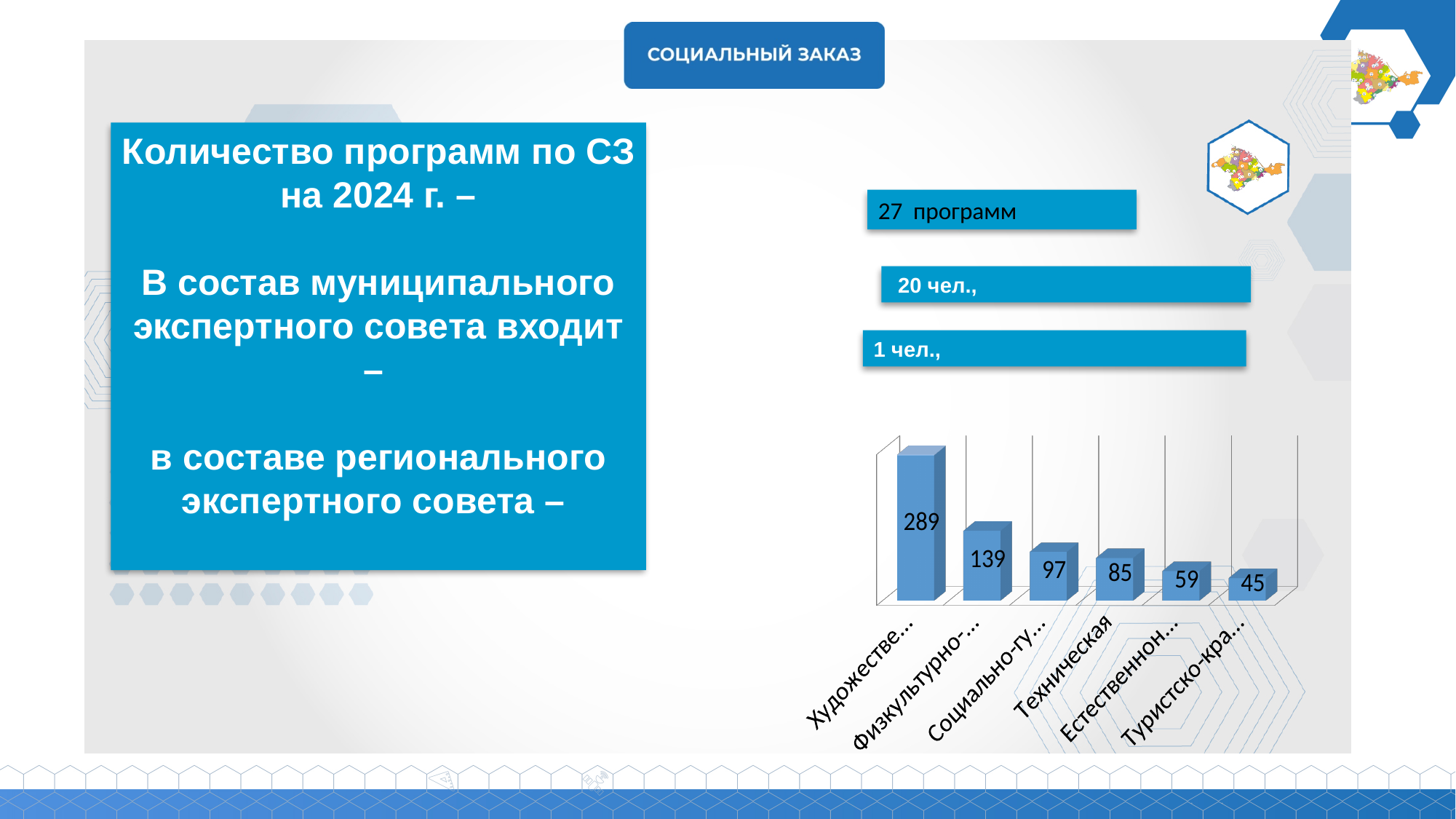
Which category has the highest value? Художестве... Which is larger, the value for "Социально-гу..." or the value for Техническая? Социально-гу... Do the values rise or fall from left to right along the x axis? Fall What kind of chart is shown on the slide? Bar chart What is the difference between the values for Техническая and "Естественнон..."? 26 How many categories are shown in the bar chart? 6 Which category has the lowest value? Туристско-кра... What is the value of the first (leftmost) bar, labelled "Художестве..."? 289 What is the value of the last (rightmost) bar, labelled "Туристско-кра..."? 45 What is the difference between the values for "Художестве..." and "Физкультурно-..."? 150 What is the value for the Техническая category? 85 What is the value of the bar labelled "Физкультурно-..."? 139